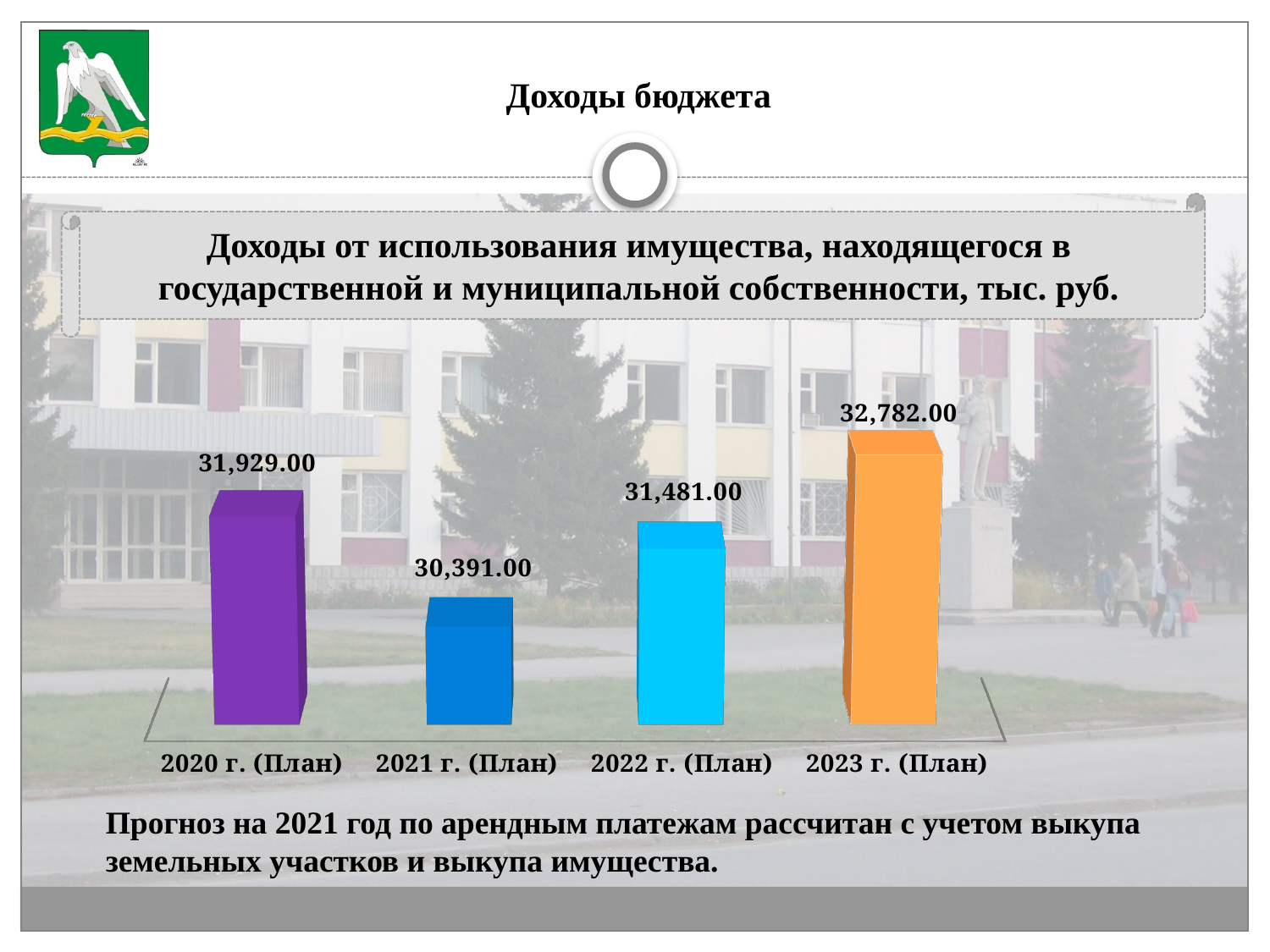
Which year has the lowest value? 2021 г. (План) How many categories are shown in the chart? 4 What is the value for 2022 г. (План)? 31,481.00 What is the difference between the values for 2023 г. (План) and 2020 г. (План)? 853.00 What is the value for 2020 г. (План)? 31,929.00 From 2021 г. (План) to 2023 г. (План), do the values rise or fall? Rise Which is larger, the value for 2020 г. (План) or 2022 г. (План)? 2020 г. (План) Which year has the highest value? 2023 г. (План) What is the value for 2023 г. (План)? 32,782.00 What is the value for 2021 г. (План)? 30,391.00 What is the difference between the values for 2020 г. (План) and 2021 г. (План)? 1,538.00 What kind of chart is shown on the slide? Bar chart